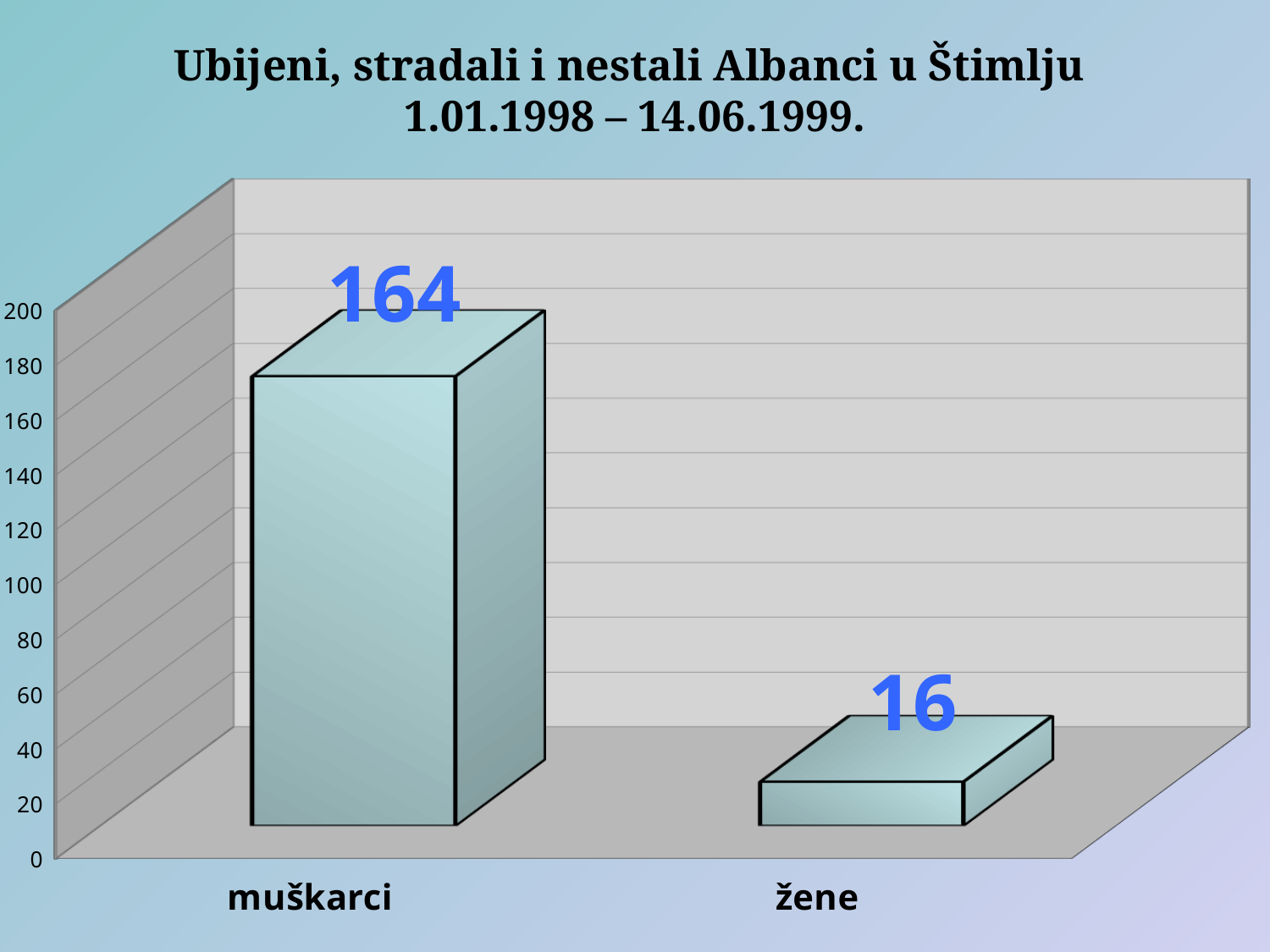
Is the value for muškarci greater or less than 100? greater How many categories are shown on the chart? 2 Which category has the highest value? muškarci What is the total of the two values shown on the chart? 180 What is the value for žene? 16 What is the difference between the values for muškarci and žene? 148 Which category has the lowest value? žene What is the value for muškarci? 164 What is the title of the chart? Ubijeni, stradali i nestali Albanci u Štimlju 1.01.1998 – 14.06.1999. Is the value for žene greater or less than 40? less What kind of chart is shown on the slide? bar chart Which is larger, the value for muškarci or the value for žene? muškarci